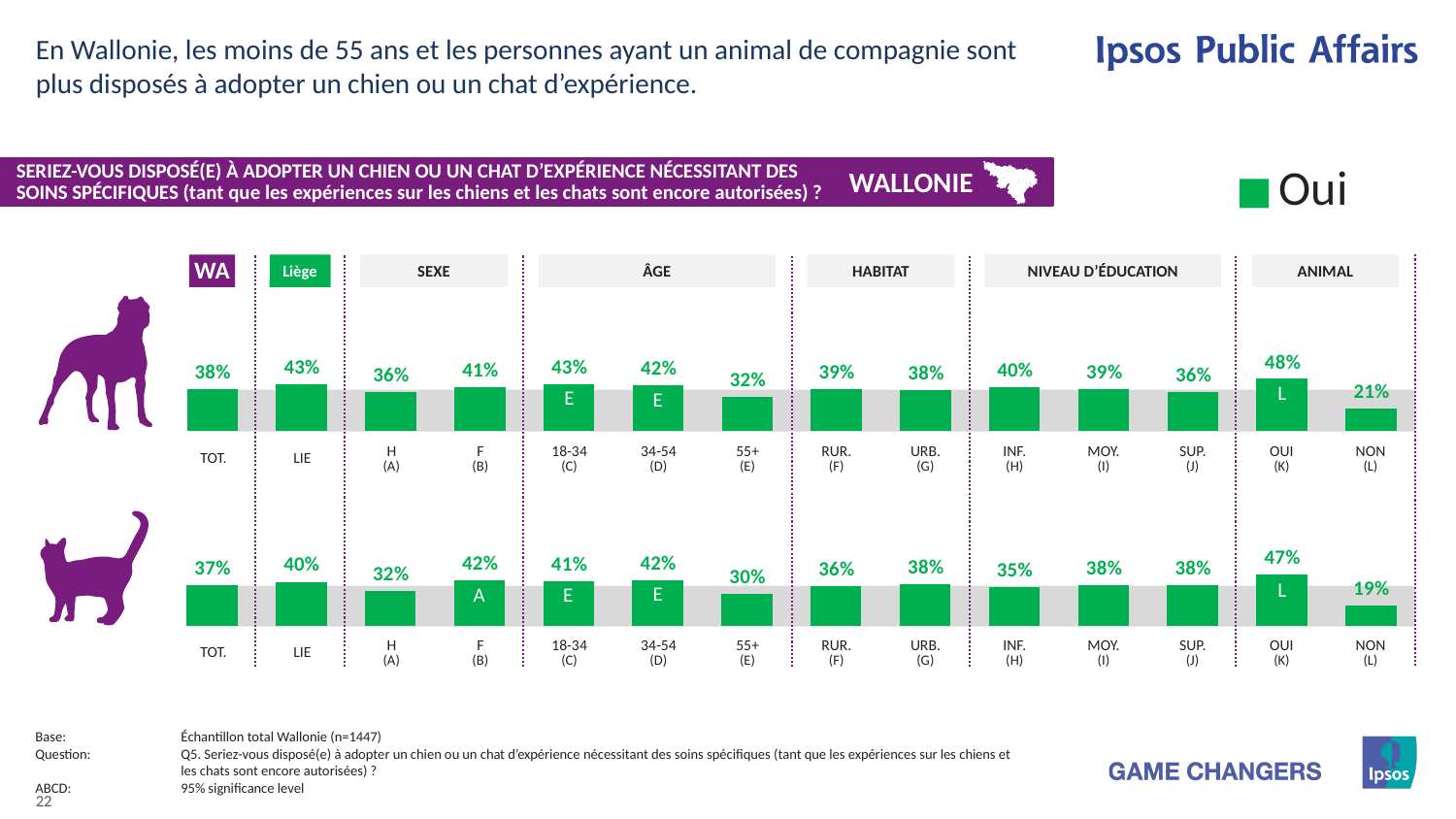
What type of chart is used on this slide? Bar chart In the top (dog) chart, which is larger, the value for RUR. (F) or the value for URB. (G)? RUR. (F) In the bottom (cat) chart, what is the value for INF. (H)? 35% In the bottom (cat) chart, what is the value for LIE? 40% In the bottom (cat) chart, which is larger, the value for H (A) or the value for F (B)? F (B) In the top (dog) chart, what is the value for 55+ (E)? 32% In the top (dog) chart, what is the value for TOT.? 38% In the bottom (cat) chart, which category has the lowest value? NON (L) In the top (dog) chart, what is the difference between the values for OUI (K) and NON (L)? 27% What is the only legend entry shown on the slide? Oui In the bottom (cat) chart, what is the difference between the values for 34-54 (D) and 55+ (E)? 12% In the top (dog) chart, which category has the highest value? OUI (K)